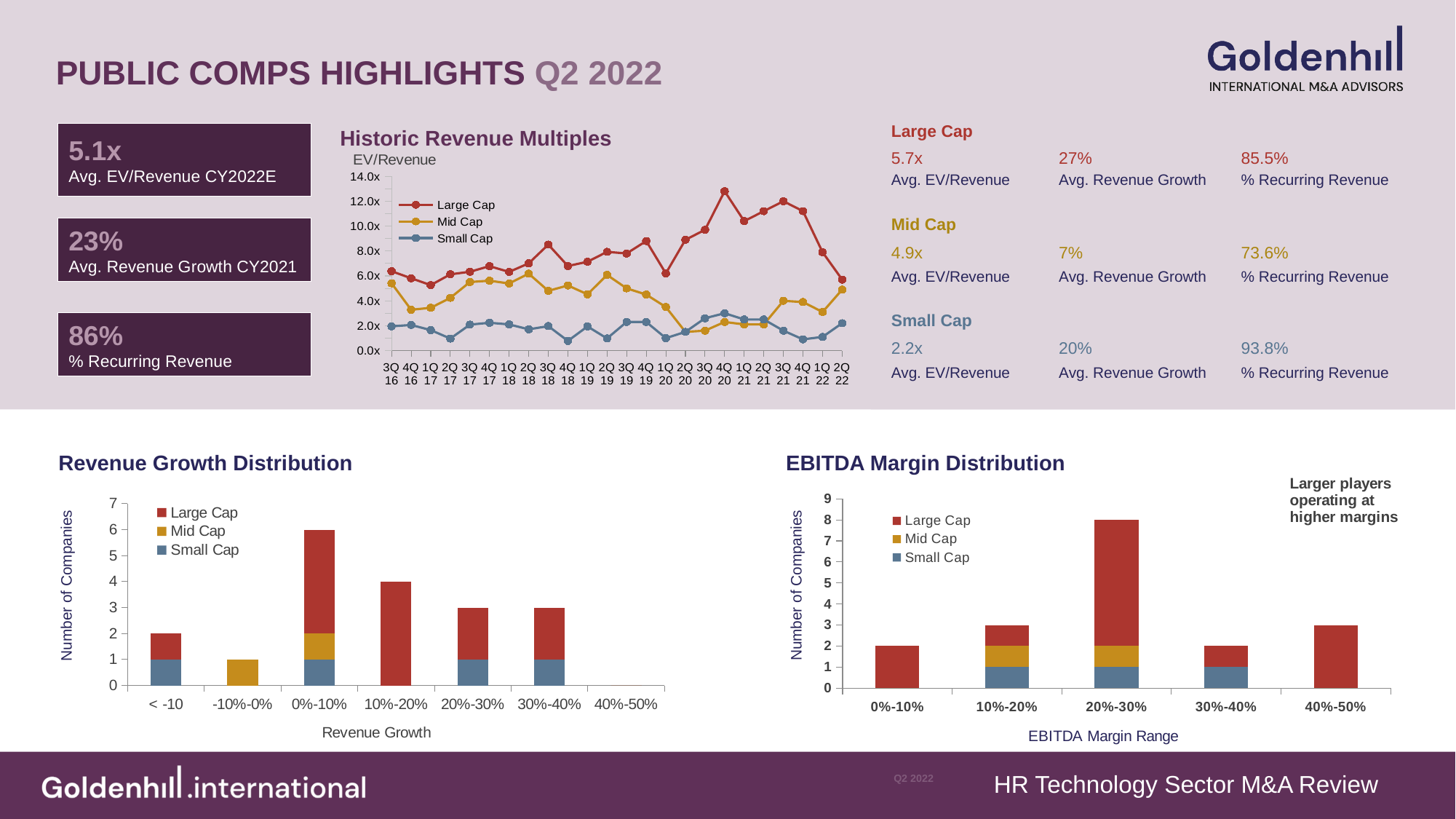
What kind of chart is the Revenue Growth Distribution chart? bar chart In the Revenue Growth Distribution chart, which revenue growth range has the highest total number of companies? 0%-10% In the Revenue Growth Distribution chart, what is the total number of companies in the 10%-20% range? 4 In the EBITDA Margin Distribution chart, how many more companies are in the 20%-30% range than in the 10%-20% range? 5 In the Historic Revenue Multiples chart, is the Mid Cap value at 1Q 17 greater or less than 4.0x? less In the Historic Revenue Multiples chart, does the Large Cap line rise or fall from 3Q 21 to 2Q 22? fall How many revenue growth categories are shown on the x axis of the Revenue Growth Distribution chart? 7 What kind of chart is the Historic Revenue Multiples chart? line chart In the Historic Revenue Multiples chart, is the Large Cap value at 4Q 20 greater or less than 12.0x? greater How many series does the legend of the Historic Revenue Multiples chart list? 3 In the EBITDA Margin Distribution chart, which EBITDA margin range has the most companies? 20%-30% In the EBITDA Margin Distribution chart, what is the total number of companies in the 20%-30% range? 8